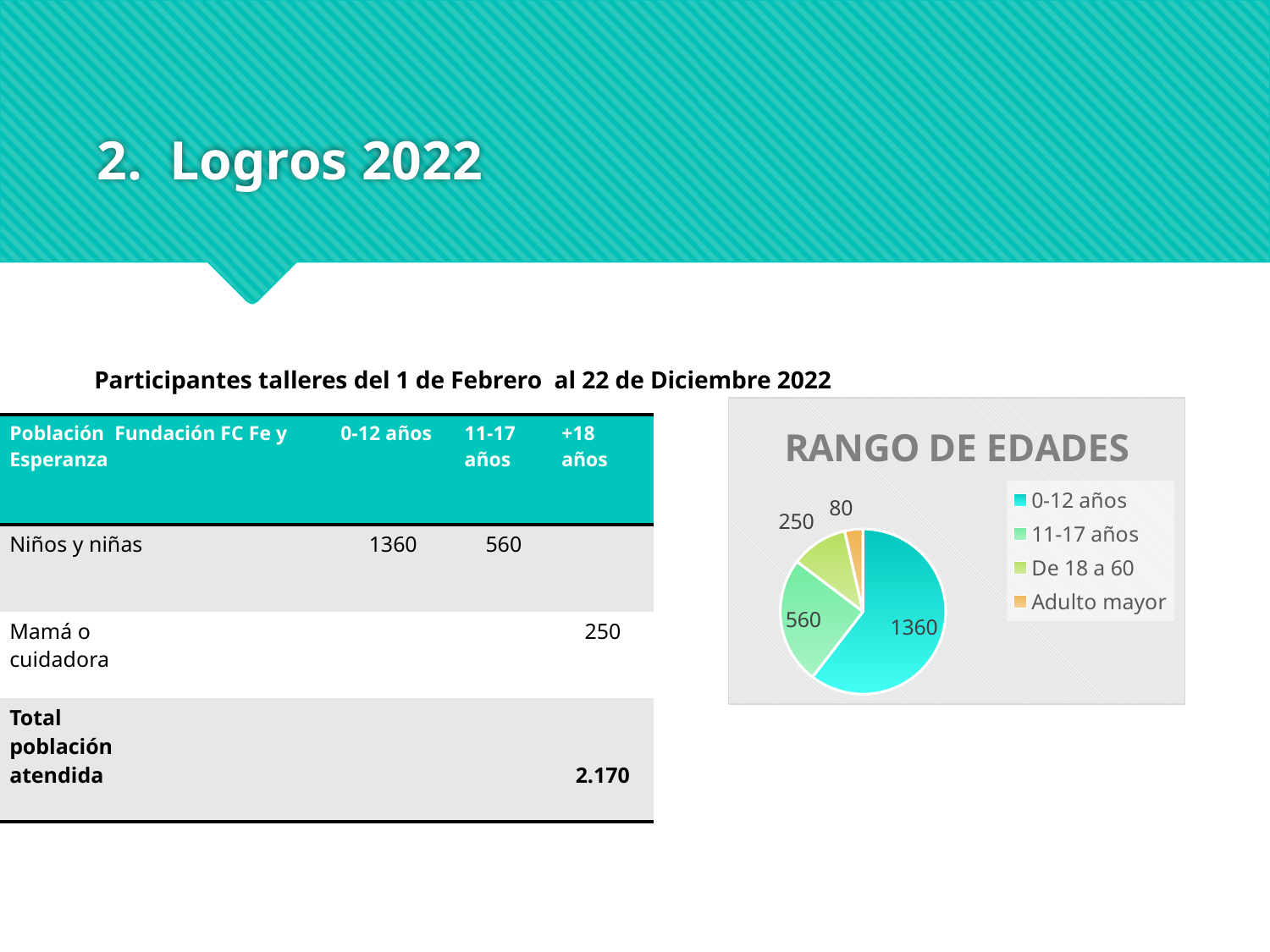
Which category has the largest slice of the pie? 0-12 años What is the value for the Adulto mayor slice? 80 Which category has the smallest slice of the pie? Adulto mayor What is the title of the chart? RANGO DE EDADES What kind of chart is shown on the slide? pie chart What is the total of all four slices in the pie chart? 2250 What is the difference between the 0-12 años value and the 11-17 años value? 800 What is the value for the 11-17 años slice? 560 Which is larger, the De 18 a 60 slice or the Adulto mayor slice? De 18 a 60 How many categories does the pie chart's legend list? 4 What is the value for the 0-12 años slice? 1360 What is the value for the De 18 a 60 slice? 250